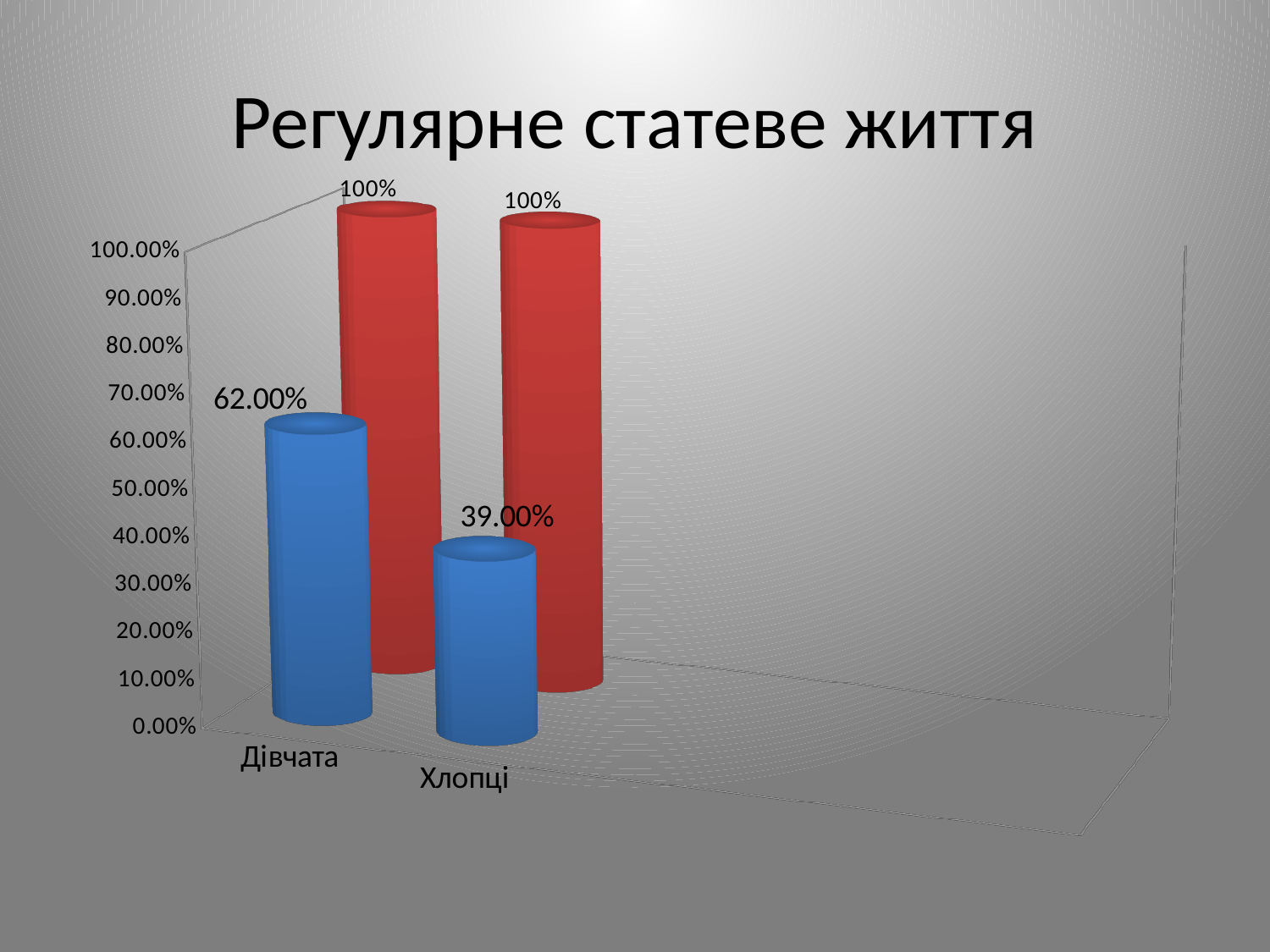
What is the value of the red bar for Дівчата? 100% What is the value of the blue bar for Хлопці? 39.00% What is the value of the red bar for Хлопці? 100% What colour are the bars that reach 100%? red What is the value of the blue bar for Дівчата? 62.00% Which category has the higher blue bar, Дівчата or Хлопці? Дівчата How many categories are shown on the x axis? 2 What is the difference between the blue bar values for Дівчата and Хлопці? 23.00% What type of chart is shown on the slide? bar chart Which category has the lowest blue bar value? Хлопці Is the blue bar value for Хлопці greater or less than 50.00%? less What is the title of the chart? Регулярне статеве життя